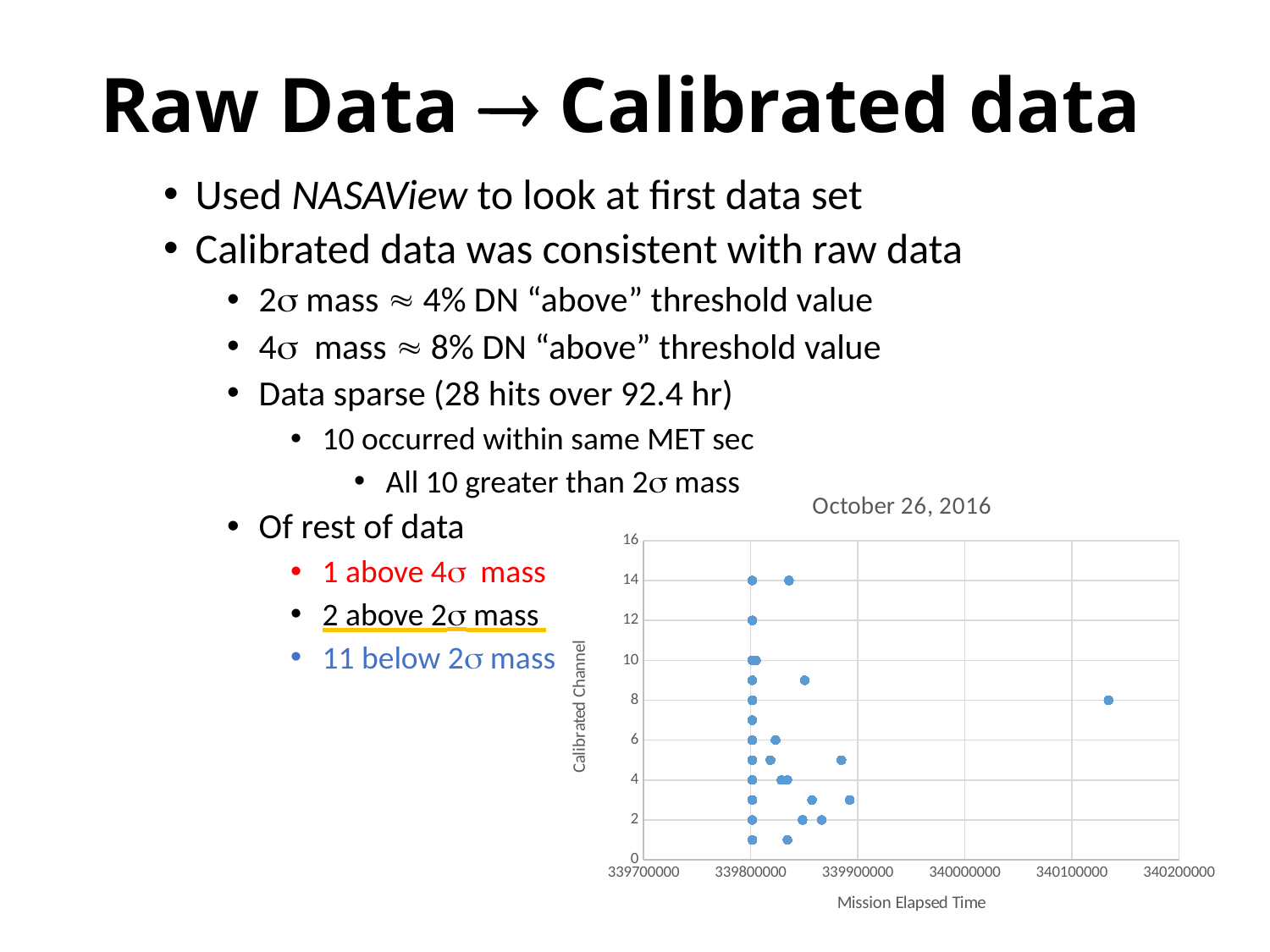
What is the highest Calibrated Channel value reached by any point on the chart? 14 What is the title of the chart? October 26, 2016 Is the Mission Elapsed Time of the isolated point at the far right greater or less than 340100000? greater Is the highest point on the chart greater or less than 12 on the Calibrated Channel axis? greater Is the Calibrated Channel value of the isolated point at the far right greater or less than 10? less What is the Calibrated Channel value of the isolated point at the far right of the chart? 8 What is the label of the x axis of the chart? Mission Elapsed Time Which has the larger Calibrated Channel value: the isolated point at the far right or the highest points near the left of the chart? the highest points near the left What kind of chart is shown on the slide? scatter chart